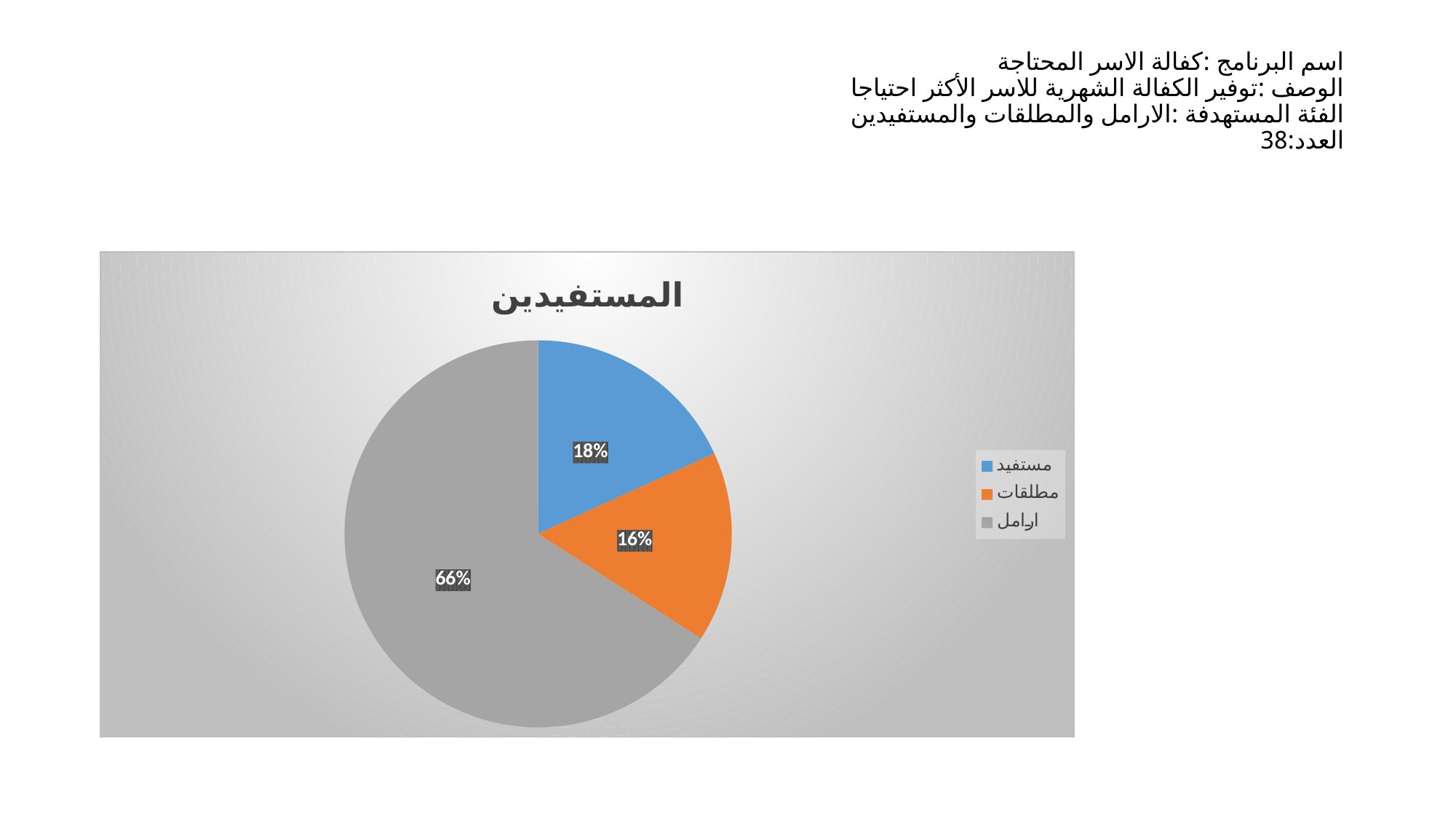
Which category has the smallest share of the pie? مطلقات Which slice is larger, مستفيد or مطلقات? مستفيد What is the title of the chart? المستفيدين What percentage of the pie does the ارامل slice represent? 66% What percentage of the pie does the مستفيد slice represent? 18% How many slices does the pie chart have? 3 What percentage of the pie does the مطلقات slice represent? 16% What kind of chart is shown on the slide? pie chart What colour is the ارامل slice in the pie chart? gray What is the difference in percentage points between the ارامل slice and the مستفيد slice? 48 How many entries does the legend list? 3 Which category has the largest share of the pie? ارامل